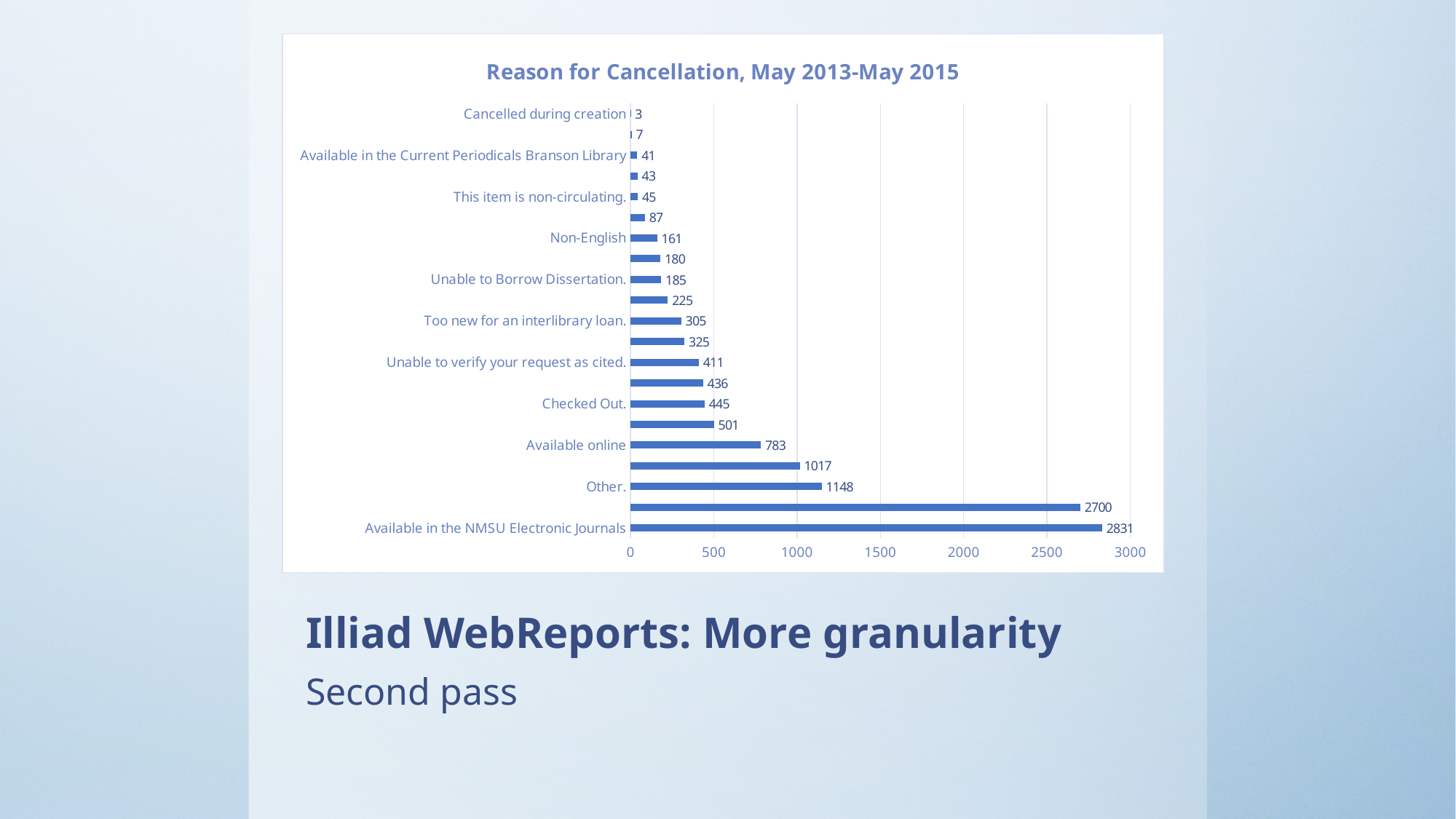
What is the value for 'Other.'? 1148 Which is larger, the value for 'Checked Out.' or the value for 'Too new for an interlibrary loan.'? Checked Out. What is the value for 'Available in the NMSU Electronic Journals'? 2831 What is the value for 'Non-English'? 161 Which reason for cancellation has the highest value? Available in the NMSU Electronic Journals What is the difference between the values for 'Other.' and 'Available online'? 365 Which reason for cancellation has the lowest value? Cancelled during creation Is the value for 'Available online' greater or less than 500? greater What type of chart is shown on the slide? bar chart What is the value for 'Available online'? 783 How many bars are plotted in the chart? 21 What is the title of the chart? Reason for Cancellation, May 2013-May 2015